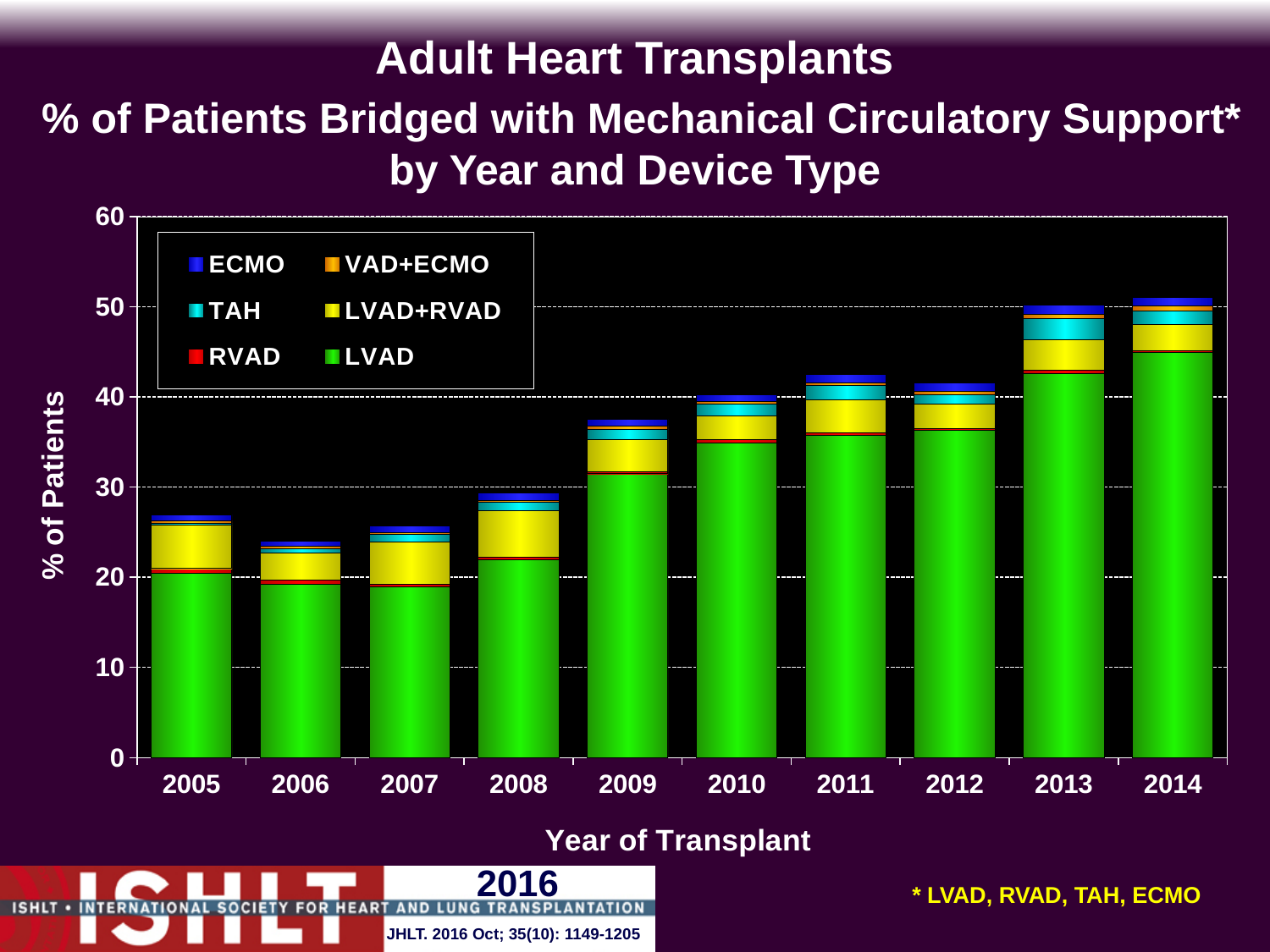
Is the LVAD value for 2014 greater or less than 40? greater Which colour represents LVAD in the legend? Green What kind of chart is shown on the slide? Stacked bar chart What is the title of the x axis? Year of Transplant How many years are shown along the x axis of the chart? 10 How many device types does the legend list? 6 Which has the larger total bar, 2008 or 2009? 2009 Do the total bar heights generally rise or fall from 2005 to 2014? Rise Is the total value for 2011 greater or less than 40? greater Is the total value for 2009 greater or less than 30? greater